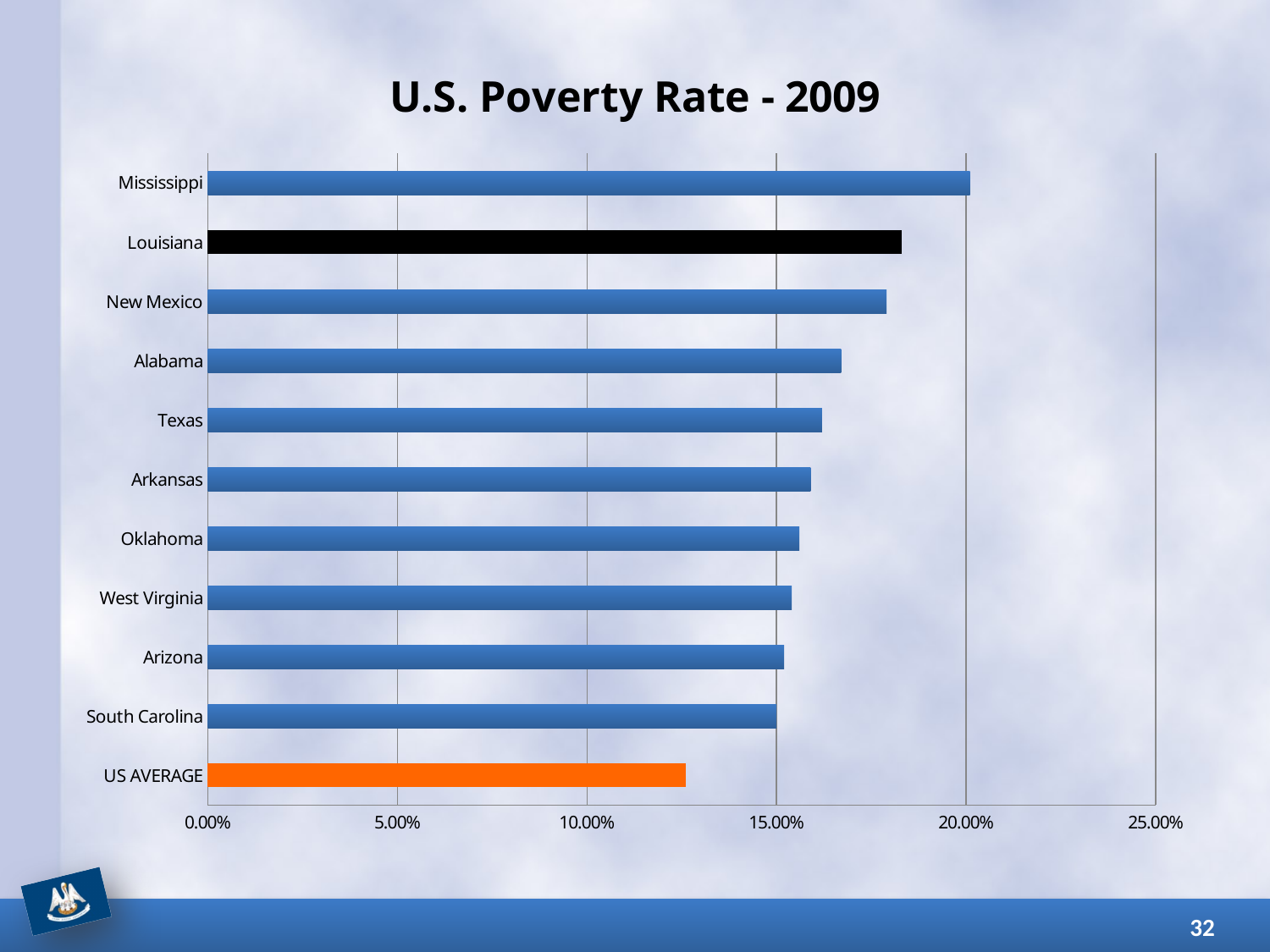
Which category has the highest poverty rate in the chart? Mississippi Which category has the lowest value in the chart? US AVERAGE Is the value for US AVERAGE greater or less than 15.00%? less Is the value for Louisiana greater or less than 20.00%? less Is the value for Oklahoma greater or less than 15.00%? greater What colour is the bar for Louisiana? black How many categories (bars) are shown in the chart? 11 What is the title of the chart? U.S. Poverty Rate - 2009 What kind of chart is shown on the slide? bar chart Which has a higher value, Texas or US AVERAGE? Texas Which has a higher poverty rate, Louisiana or Alabama? Louisiana